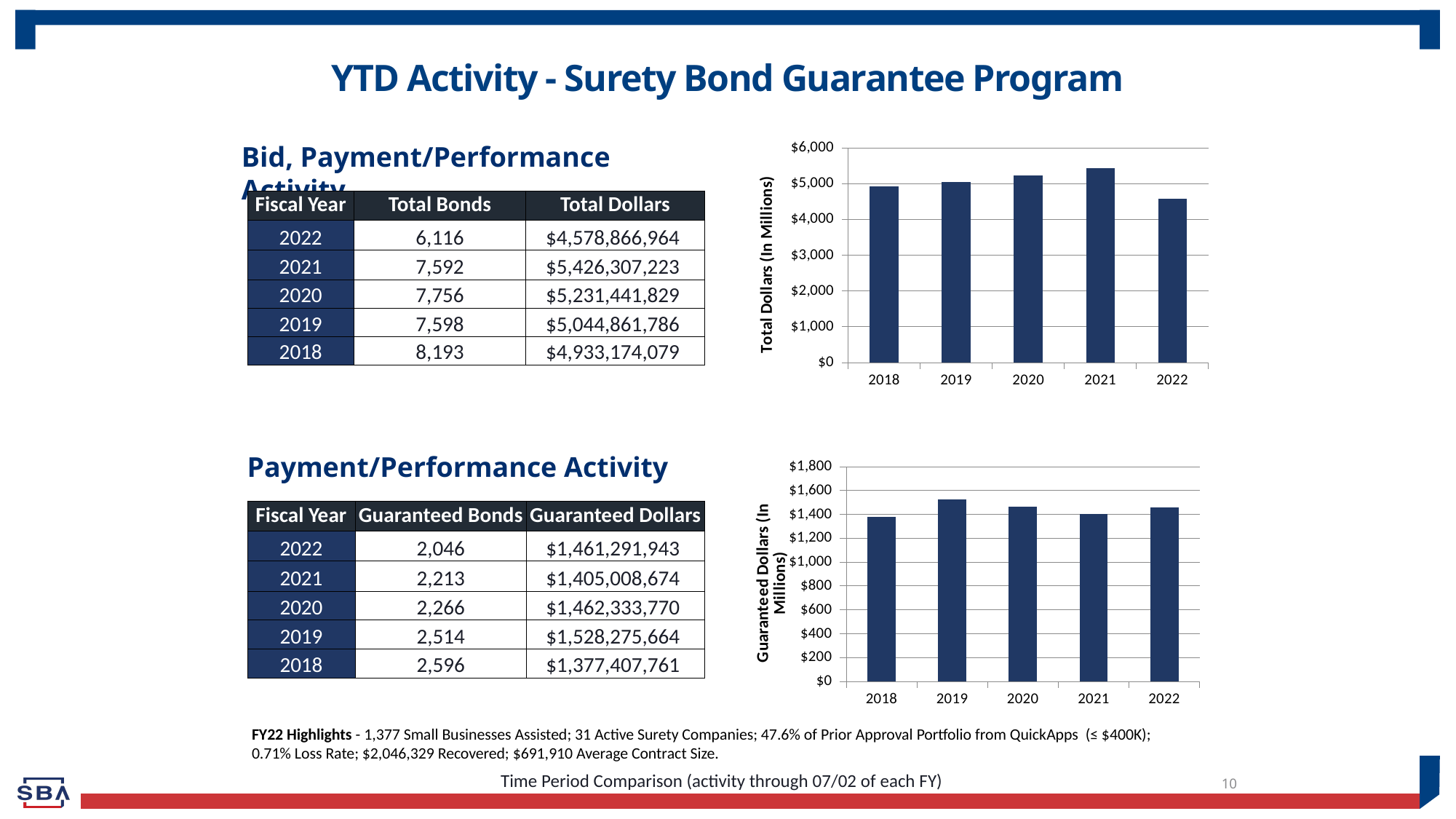
In the top chart (Total Dollars in Millions), is the value for 2021 greater or less than $5,000? greater What is the y-axis title of the bottom chart? Guaranteed Dollars (In Millions) What kind of chart is the top chart on the right of the slide? bar chart In the top chart (Total Dollars in Millions), how many years are plotted on the x axis? 5 In the top chart (Total Dollars in Millions), do the bars rise or fall from 2018 to 2021? rise In the top chart (Total Dollars in Millions), which year has the highest bar? 2021 In the top chart (Total Dollars in Millions), which year has the lowest bar? 2022 In the bottom chart (Guaranteed Dollars in Millions), how many bars are shown? 5 In the top chart (Total Dollars in Millions), is the value for 2022 greater or less than $5,000? less In the bottom chart (Guaranteed Dollars in Millions), is the value for 2019 greater or less than $1,400? greater In the bottom chart (Guaranteed Dollars in Millions), which is larger, the value for 2019 or the value for 2021? 2019 In the bottom chart (Guaranteed Dollars in Millions), which year has the highest bar? 2019